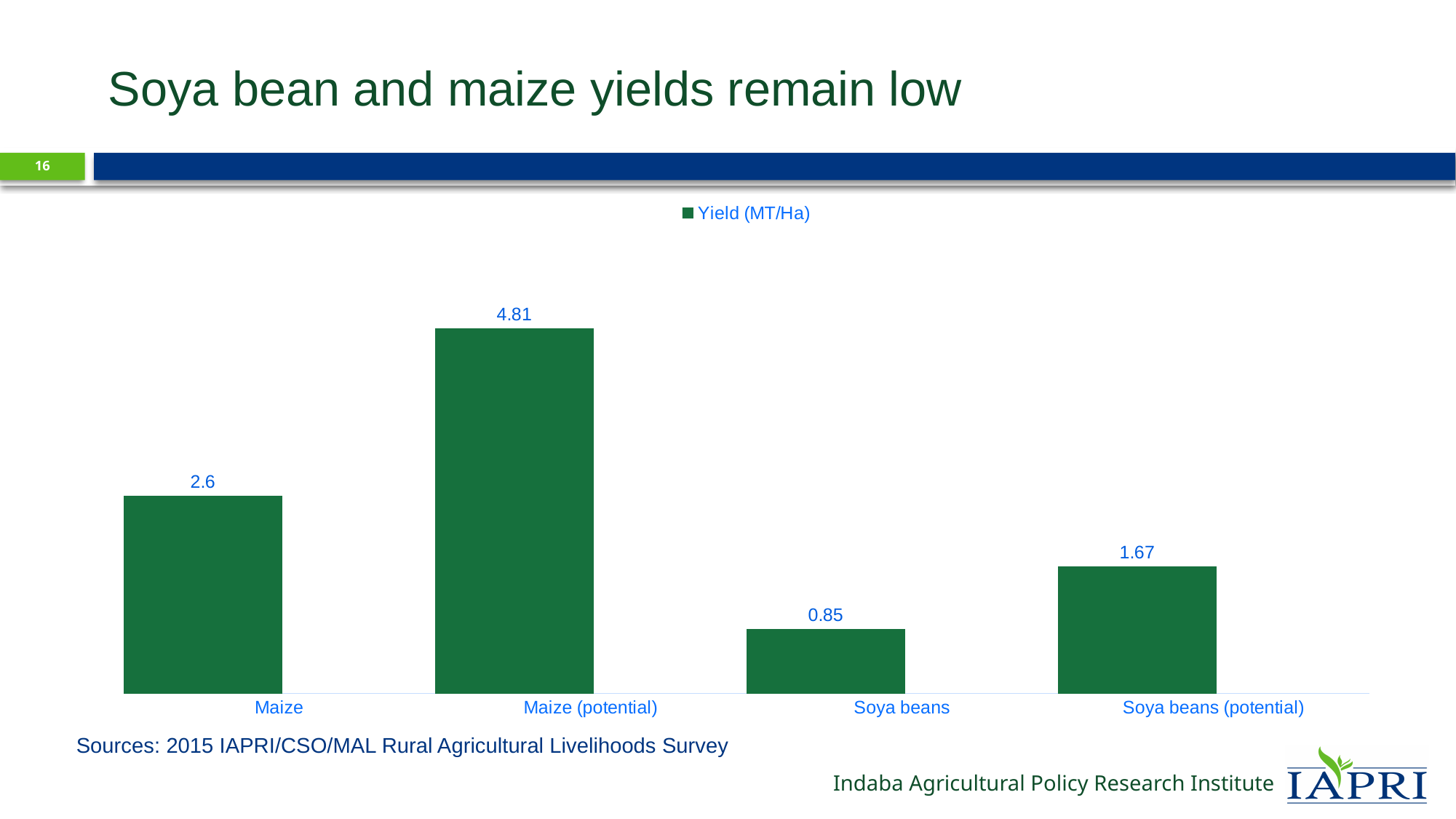
What kind of chart is shown on the slide? Bar chart Which category has the highest yield? Maize (potential) How many categories are shown on the chart? 4 What is the yield (MT/Ha) for Soya beans (potential)? 1.67 Which category has the lowest yield? Soya beans What series name does the legend show? Yield (MT/Ha) What is the yield (MT/Ha) for Maize? 2.6 What is the yield (MT/Ha) for Maize (potential)? 4.81 Which is larger, the yield for Maize or the yield for Soya beans (potential)? Maize What is the difference between the Soya beans (potential) yield and the Soya beans yield? 0.82 What is the difference between the Maize (potential) yield and the Maize yield? 2.21 What is the yield (MT/Ha) for Soya beans? 0.85